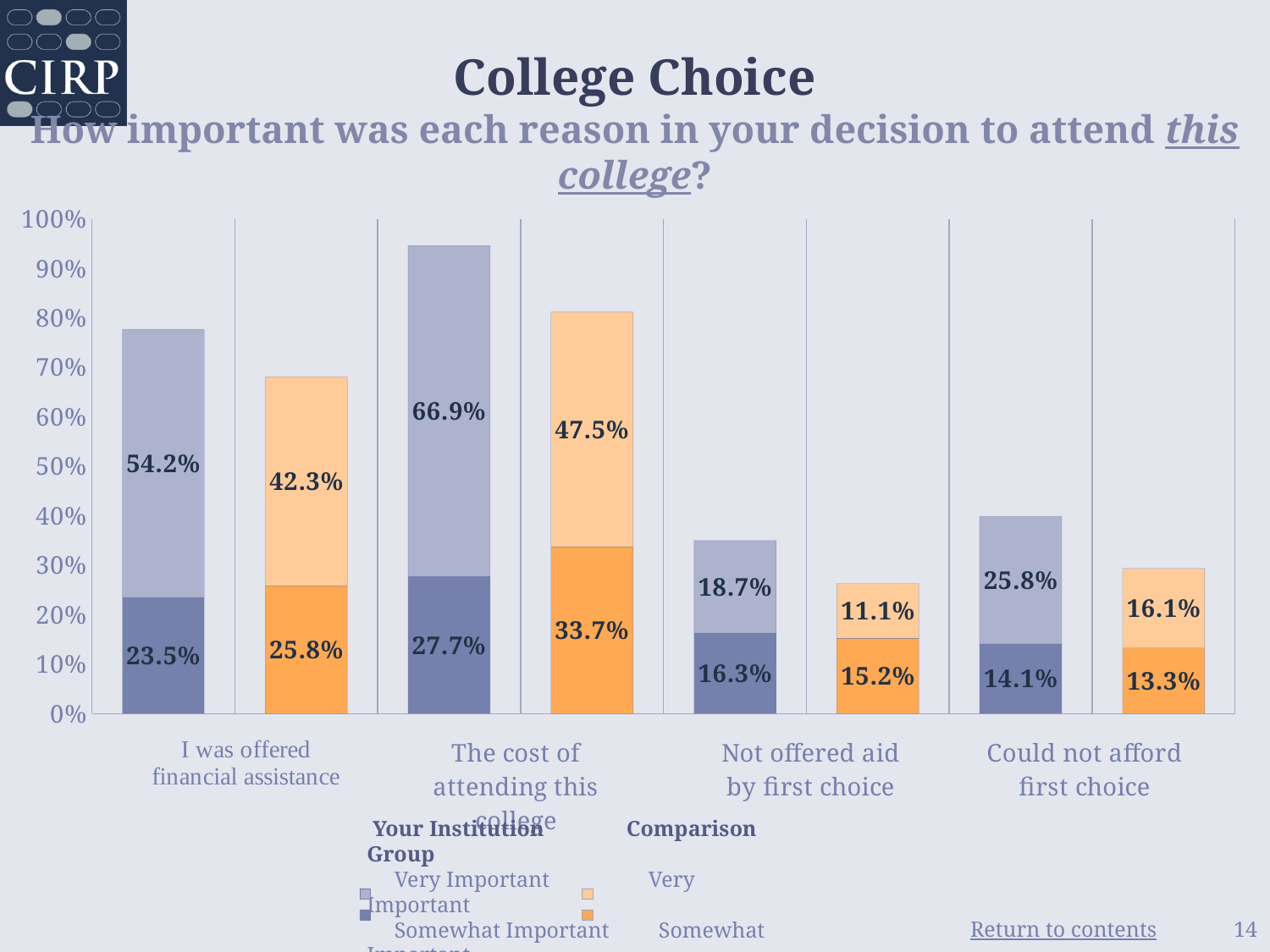
What percentage of the Comparison Group rated "Not offered aid by first choice" as Very Important? 11.1% What is the difference between the Very Important percentages for Your Institution and the Comparison Group on "The cost of attending this college"? 19.4% Is the total stacked bar for Your Institution on "The cost of attending this college" greater or less than 90%? greater What percentage of the Comparison Group rated "I was offered financial assistance" as Somewhat Important? 25.8% For "I was offered financial assistance", which group has the larger Very Important percentage, Your Institution or the Comparison Group? Your Institution What percentage of students at Your Institution rated "Could not afford first choice" as Somewhat Important? 14.1% What is the combined Somewhat Important and Very Important total for Your Institution on "Not offered aid by first choice"? 35.0% Which reason has the highest Very Important percentage for Your Institution? The cost of attending this college Which reason has the lowest Very Important percentage for the Comparison Group? Not offered aid by first choice What type of chart is shown on the slide? Stacked bar chart How many reasons (categories) are shown on the x axis of the chart? 4 What percentage of students at Your Institution rated "The cost of attending this college" as Very Important? 66.9%